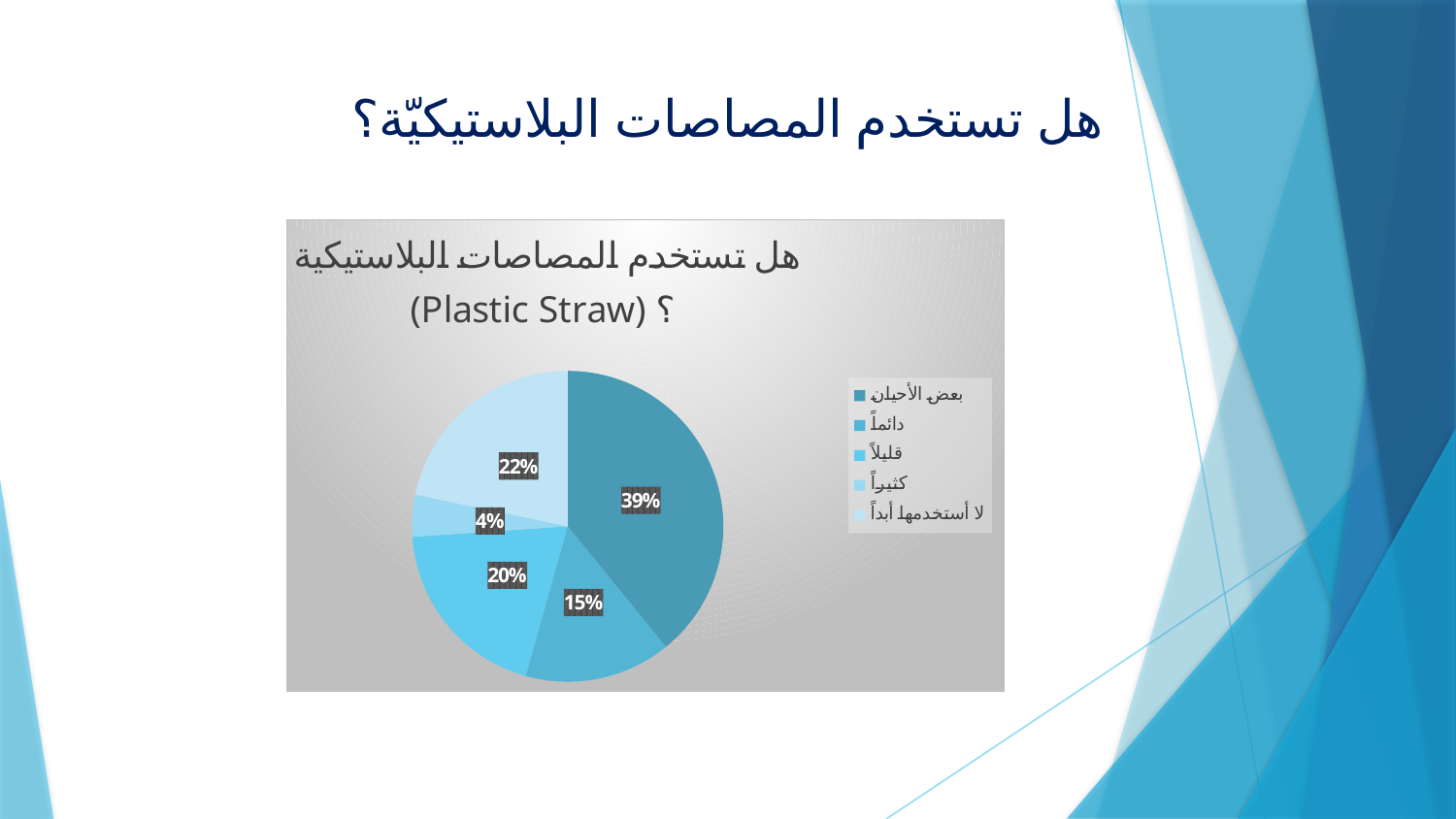
Which category has the smallest slice of the pie? كثيراً What is the difference in percentage points between the 'بعض الأحيان' slice and the 'لا أستخدمها أبداً' slice? 17 What percentage of the pie is labelled for the slice 'بعض الأحيان'? 39% Which category has the largest slice of the pie? بعض الأحيان What percentage is shown for the slice 'لا أستخدمها أبداً'? 22% What percentage is shown for the slice 'دائماً'? 15% How many categories does the legend of the pie chart list? 5 What kind of chart is shown on the slide? pie chart What percentage is shown for the slice 'قليلاً'? 20% What is the English text shown in parentheses in the chart title? Plastic Straw Which slice is larger, 'قليلاً' or 'دائماً'? قليلاً What percentage is shown for the slice 'كثيراً'? 4%